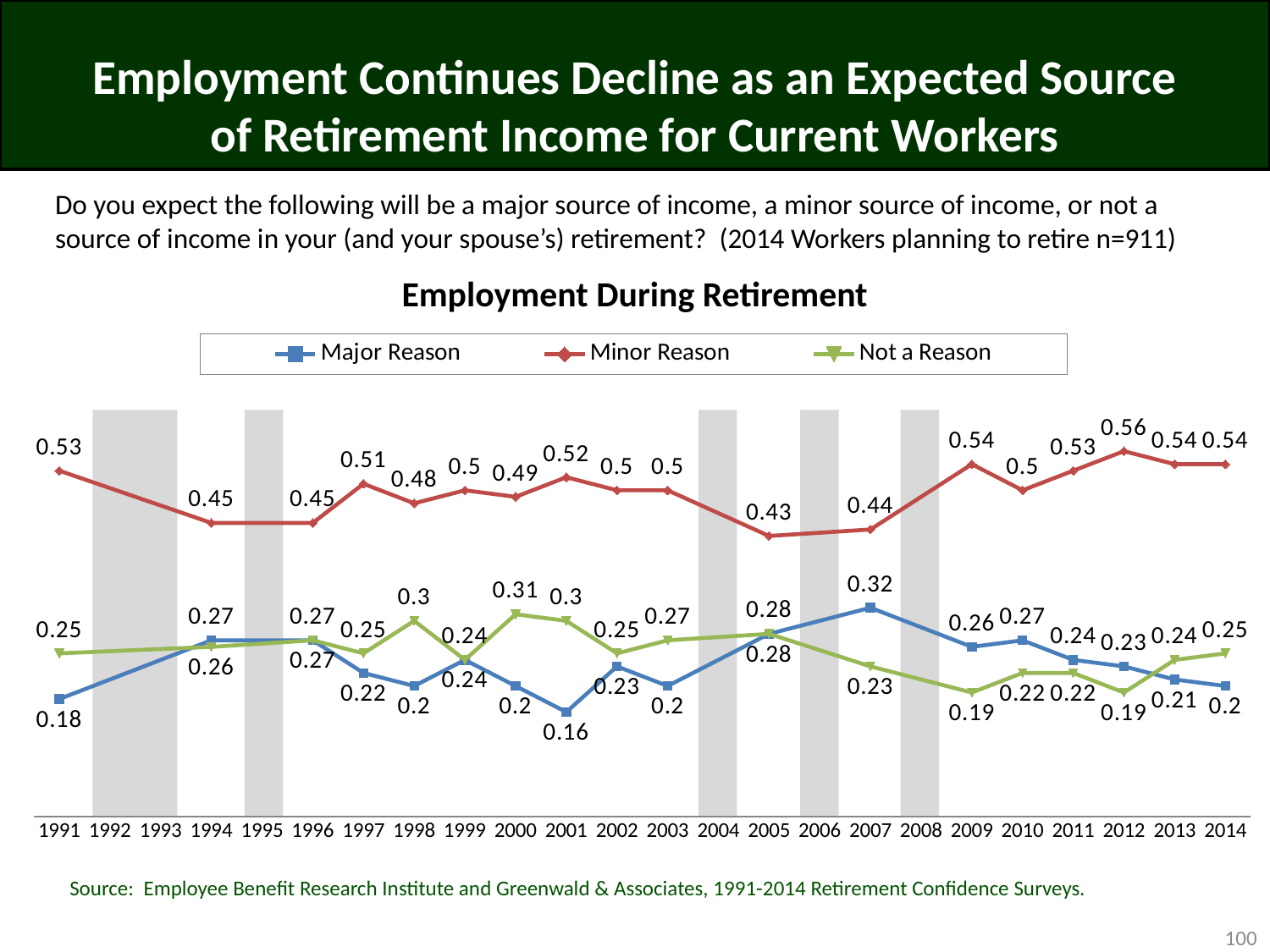
What is the difference between Minor Reason and Major Reason in 2014? 0.34 What is the highest value shown for Minor Reason? 0.56 In 2009, which is larger: Major Reason or Not a Reason? Major Reason How many series does the legend list? 3 Does the Major Reason line rise or fall from 2007 to 2014? fall In which year does Major Reason reach its highest value? 2007 What is the value for Major Reason in 1991? 0.18 What is the value for Minor Reason in 2014? 0.54 What is the value for Not a Reason in 2000? 0.31 What type of chart is shown on the slide? line chart What is the title of the chart? Employment During Retirement In which year does Major Reason reach its lowest value? 2001